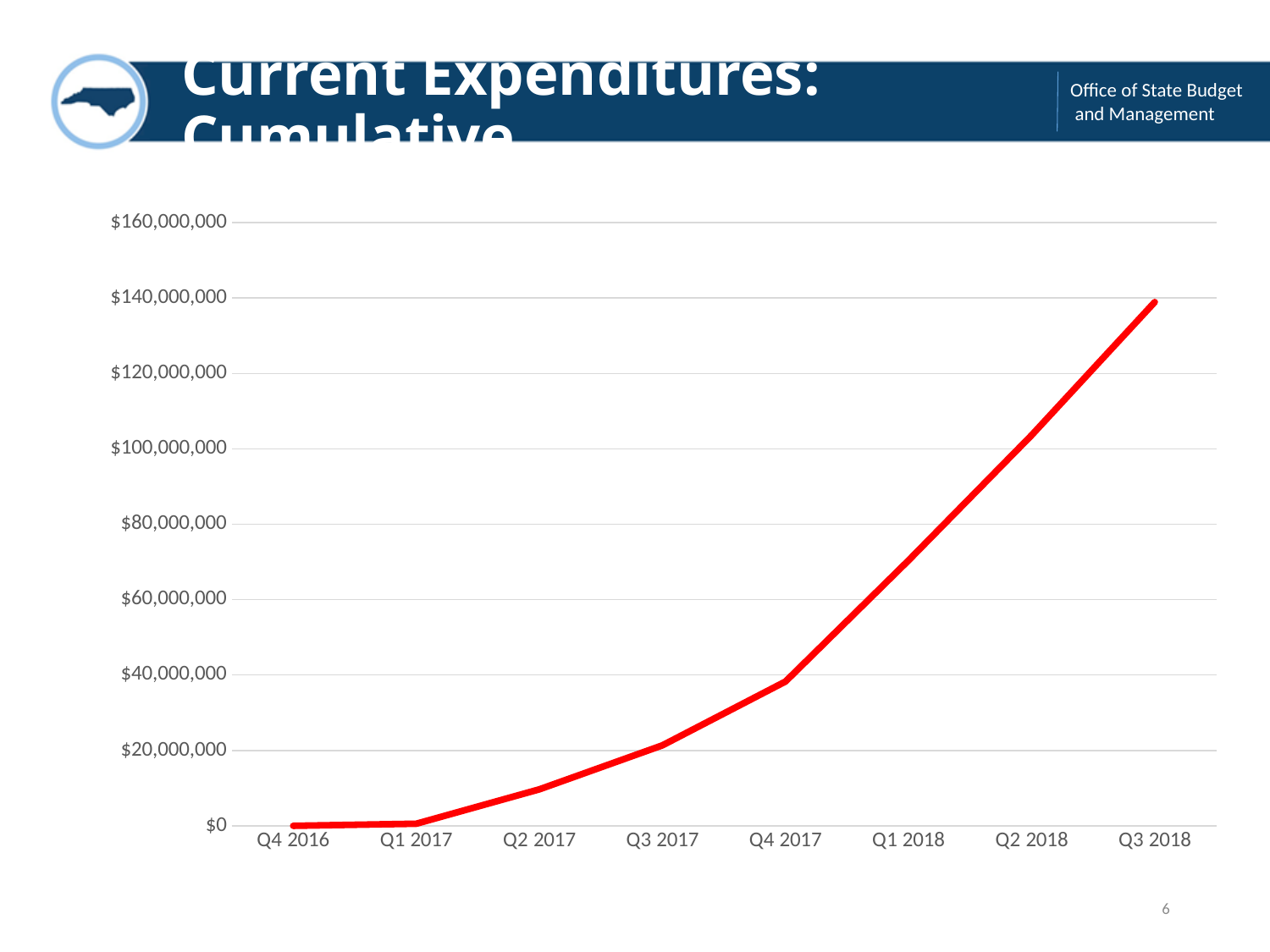
How many quarters are plotted along the x axis? 8 Is the value for Q3 2017 greater or less than $40,000,000? less What is the first quarter shown on the x axis? Q4 2016 Do the cumulative expenditure values rise or fall from Q4 2016 to Q3 2018? rise Is the value for Q3 2018 greater or less than $120,000,000? greater Is the value for Q2 2018 greater or less than $100,000,000? greater Which quarter has the lowest cumulative expenditure? Q4 2016 What is the highest value shown on the y axis? $160,000,000 Which quarter has the highest cumulative expenditure? Q3 2018 Which is larger, the value for Q1 2018 or the value for Q4 2017? Q1 2018 What kind of chart is shown on the slide? line chart